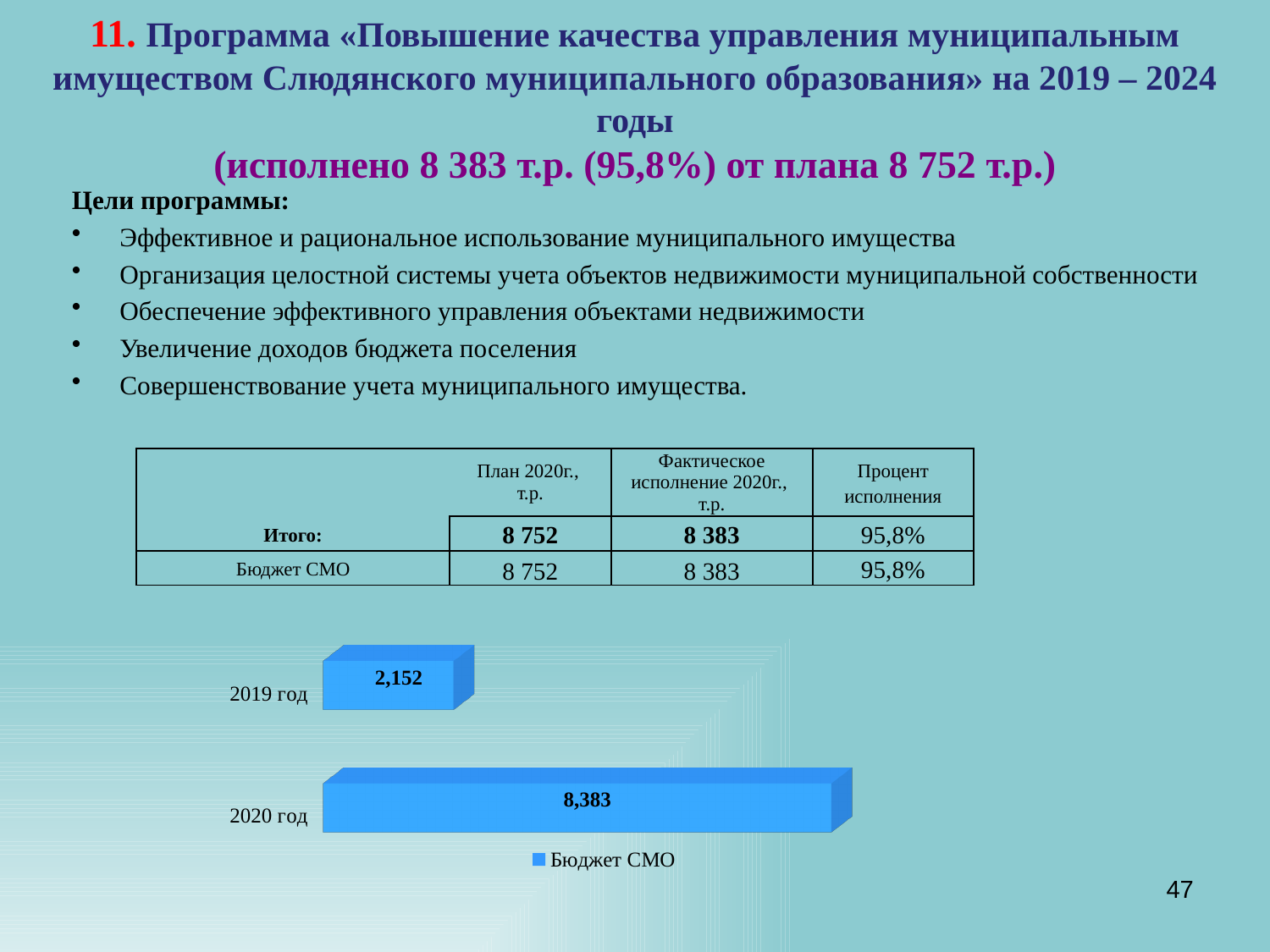
How many categories (years) are shown in the chart? 2 What kind of chart is shown on the slide? bar chart Which year has the higher value in the chart? 2020 год What is the value for 2020 год in the chart? 8,383 Do the values rise or fall from 2019 год to 2020 год? rise Is the value for 2019 год larger or smaller than the value for 2020 год? smaller What series name is shown in the chart legend? Бюджет СМО What is the difference between the values for 2020 год and 2019 год in the chart? 6,231 How many series does the chart legend list? 1 What colour are the bars in the chart? blue Which year has the lower value in the chart? 2019 год What is the value for 2019 год in the chart? 2,152